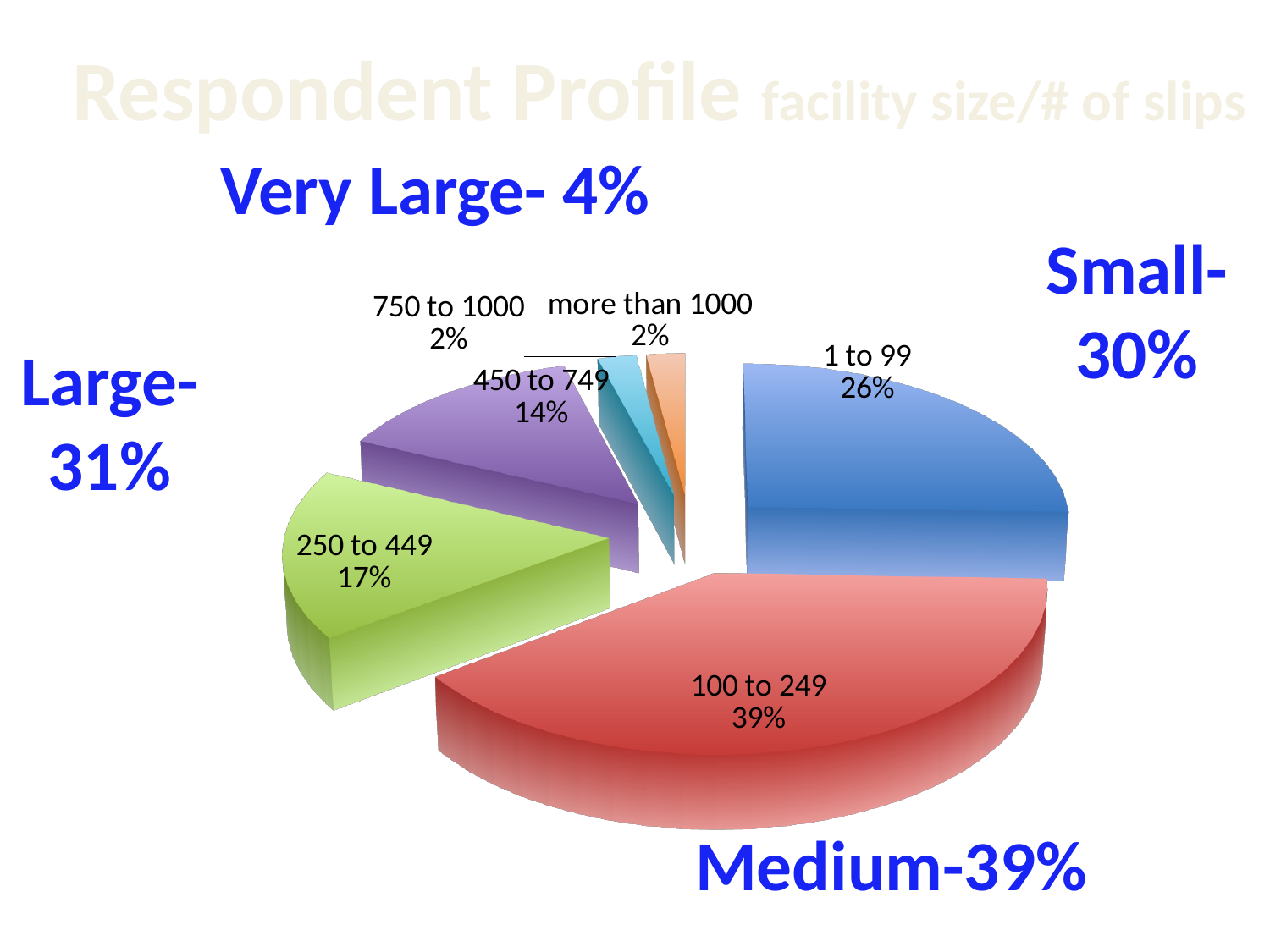
According to the slide's annotation, what percentage of respondents are labelled "Large"? 31% What is the title of the slide? Respondent Profile facility size/# of slips How many slices does the pie chart have? 6 What kind of chart is shown on the slide? pie chart Which category has the largest slice of the pie? 100 to 249 What share of the pie does the "1 to 99" slice represent? 26% What is the difference in percentage points between the "100 to 249" slice and the "1 to 99" slice? 13 What share of the pie does the "250 to 449" slice represent? 17% What share of the pie does the "450 to 749" slice represent? 14% Which slice is larger, "250 to 449" or "450 to 749"? 250 to 449